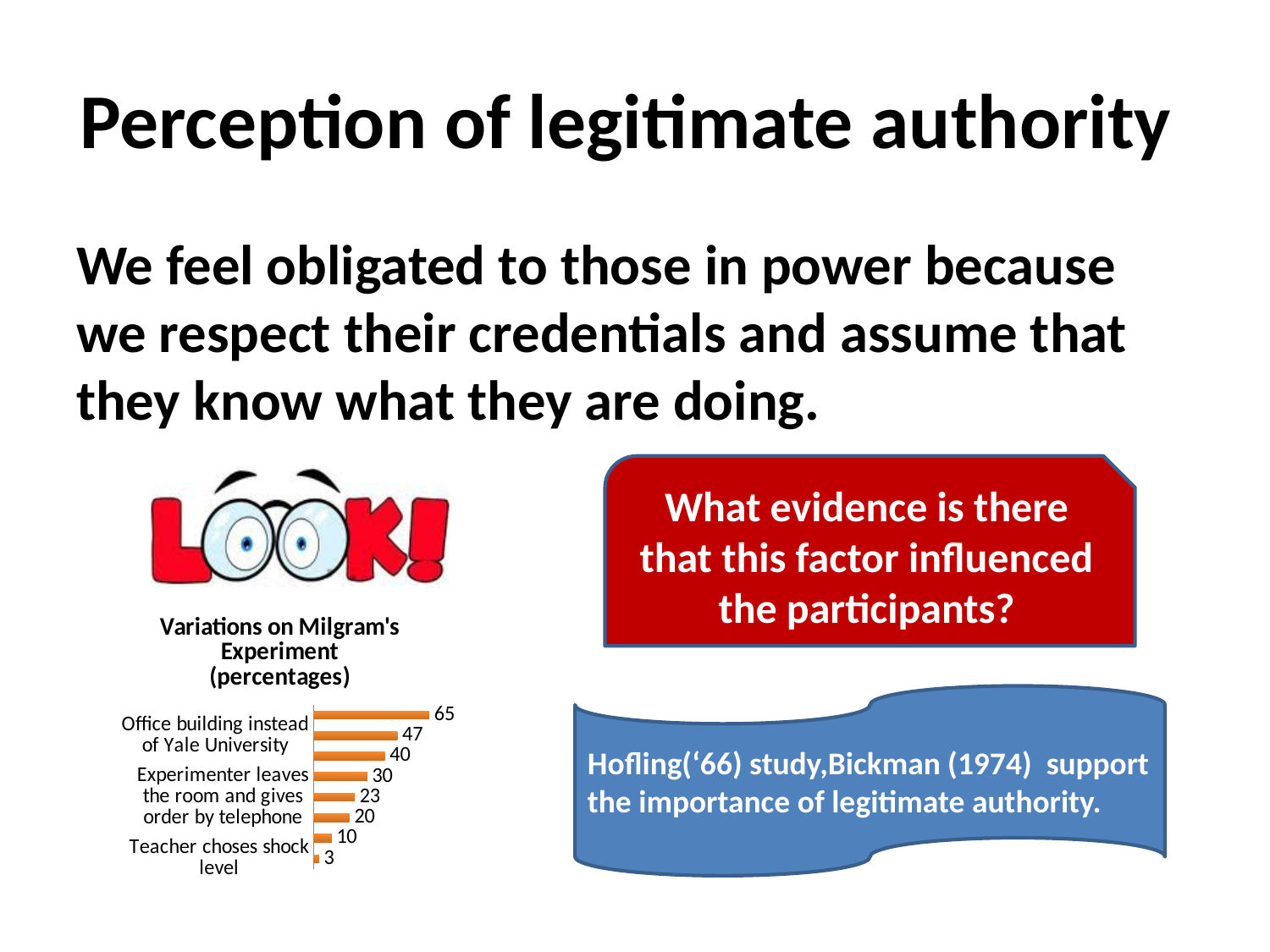
What is the value of the shortest bar in the chart? 3 What is the title of the chart? Variations on Milgram's Experiment (percentages) Which is larger, the top bar of the chart or the bottom bar? the top bar What is the difference between the largest value (65) and the smallest value (3) in the chart? 62 How many bars in the chart have a value of 40 or more? 3 What is the value of the second-longest bar in the chart? 47 What colour are the bars in the chart? orange What is the value of the longest bar in the chart? 65 How many bars are plotted in the chart? 8 What type of chart is shown on the slide? bar chart Do the bar values increase or decrease going from the top of the chart to the bottom? decrease What is the difference between the two largest values in the chart, 65 and 47? 18